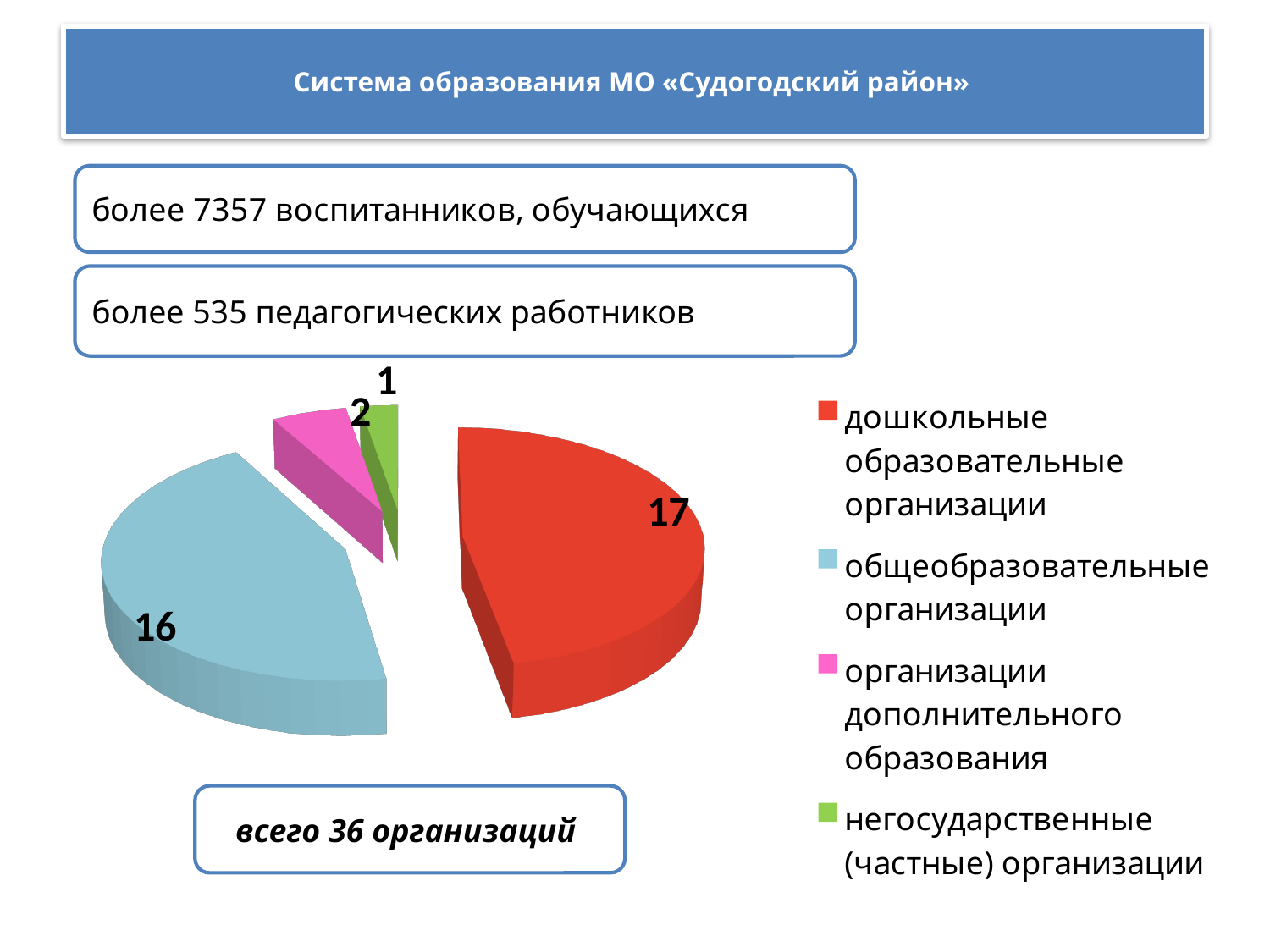
What is the value for общеобразовательные организации in the pie chart? 16 What colour is the slice for организации дополнительного образования in the pie chart? pink Which category has the smallest slice in the pie chart? негосударственные (частные) организации What type of chart is shown on the slide? pie chart What is the value for дошкольные образовательные организации in the pie chart? 17 How many entries does the legend of the pie chart list? 4 Which is larger in the pie chart: общеобразовательные организации or организации дополнительного образования? общеобразовательные организации Which category has the largest slice in the pie chart? дошкольные образовательные организации How many slices does the pie chart have? 4 What is the value for организации дополнительного образования in the pie chart? 2 What is the difference between the values for дошкольные образовательные организации and организации дополнительного образования? 15 What is the value for негосударственные (частные) организации in the pie chart? 1